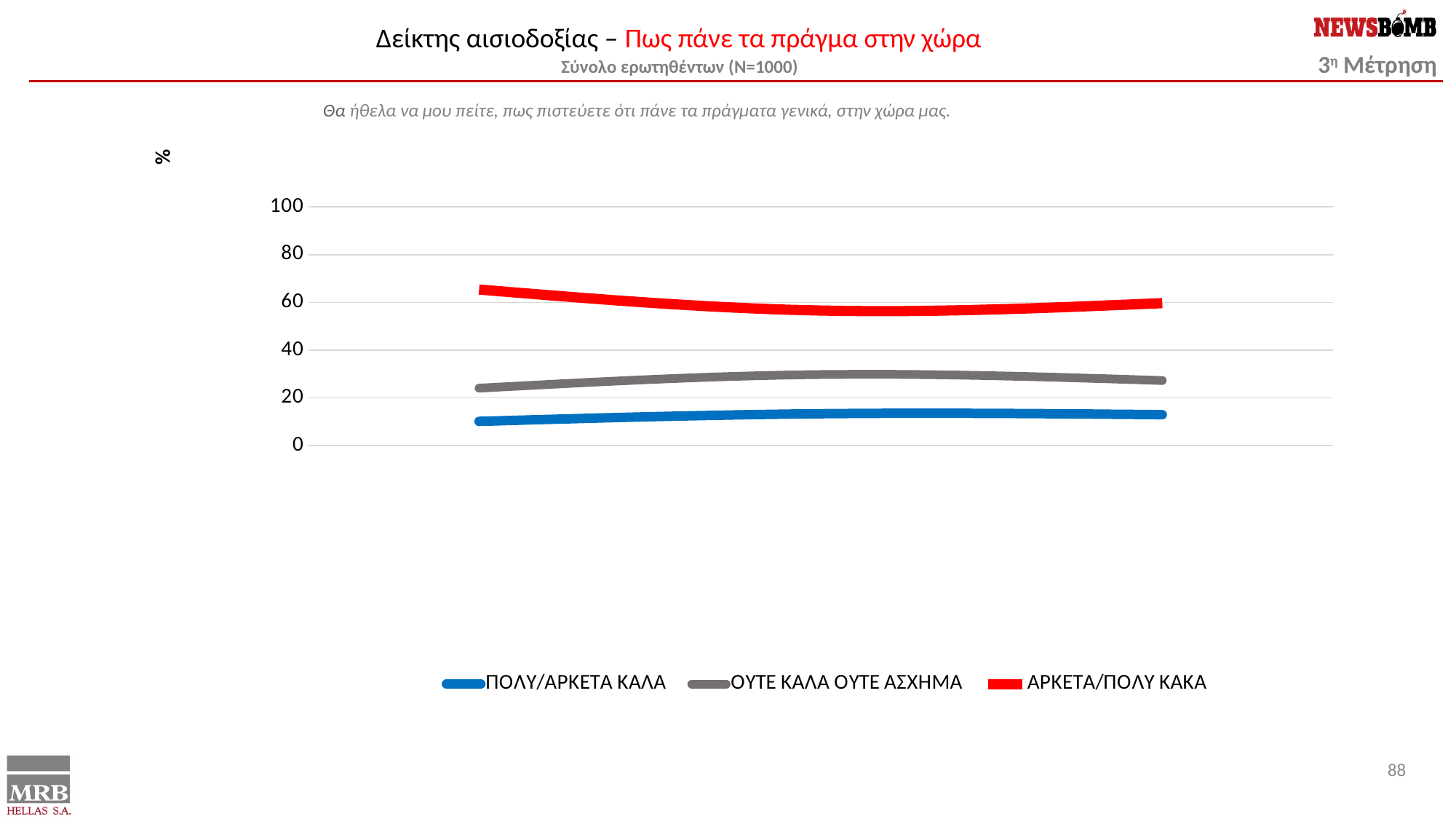
Is the first value of the ΑΡΚΕΤΑ/ΠΟΛΥ ΚΑΚΑ line greater or less than 60? greater What is the highest value shown on the y axis? 100 What is the sample size (N) stated in the chart subtitle? N=1000 Are the values for ΟΥΤΕ ΚΑΛΑ ΟΥΤΕ ΑΣΧΗΜΑ greater or less than 40? less Are the values for ΑΡΚΕΤΑ/ΠΟΛΥ ΚΑΚΑ greater or less than 40? greater Which series has the lowest values throughout the chart? ΠΟΛΥ/ΑΡΚΕΤΑ ΚΑΛΑ How many series does the legend list? 3 Which series is larger, ΟΥΤΕ ΚΑΛΑ ΟΥΤΕ ΑΣΧΗΜΑ or ΠΟΛΥ/ΑΡΚΕΤΑ ΚΑΛΑ? ΟΥΤΕ ΚΑΛΑ ΟΥΤΕ ΑΣΧΗΜΑ Which series has the highest values throughout the chart? ΑΡΚΕΤΑ/ΠΟΛΥ ΚΑΚΑ What colour is the line for ΑΡΚΕΤΑ/ΠΟΛΥ ΚΑΚΑ? red What kind of chart is shown on the slide? line chart